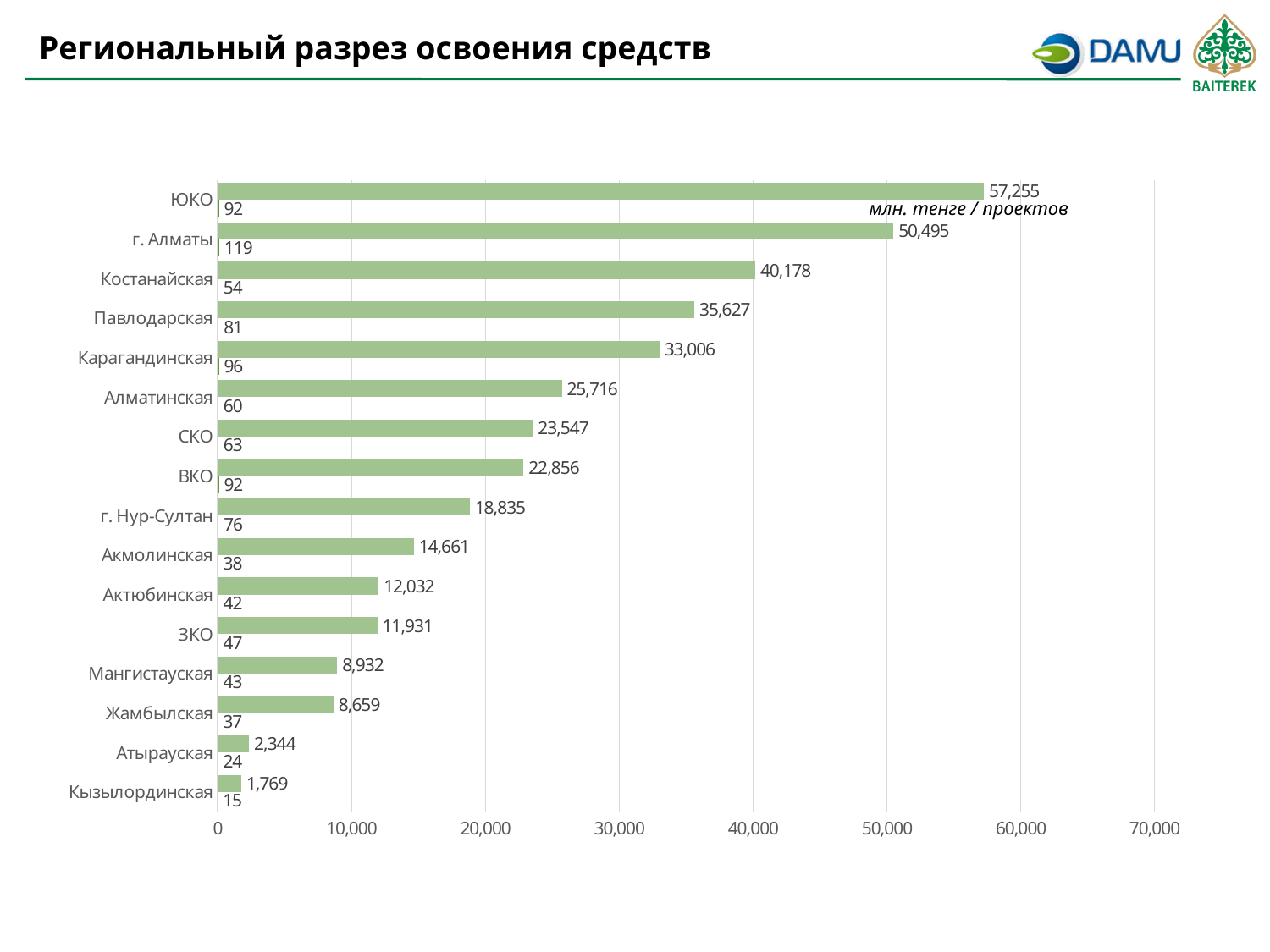
What is the title of the slide? Региональный разрез освоения средств What is the amount in million tenge for ЮКО? 57,255 How many projects are shown for г. Алматы? 119 How many regions are shown on the chart? 16 What kind of chart is shown on the slide? bar chart Which region has the lowest amount in million tenge? Кызылординская Which region has the highest amount in million tenge? ЮКО What is the difference in million tenge between ЮКО and г. Алматы? 6,760 What is the amount in million tenge for Карагандинская? 33,006 How many projects are shown for Атырауская? 24 Is the amount for Костанайская greater or less than 40,000? greater Which has a larger amount in million tenge, Актюбинская or ЗКО? Актюбинская